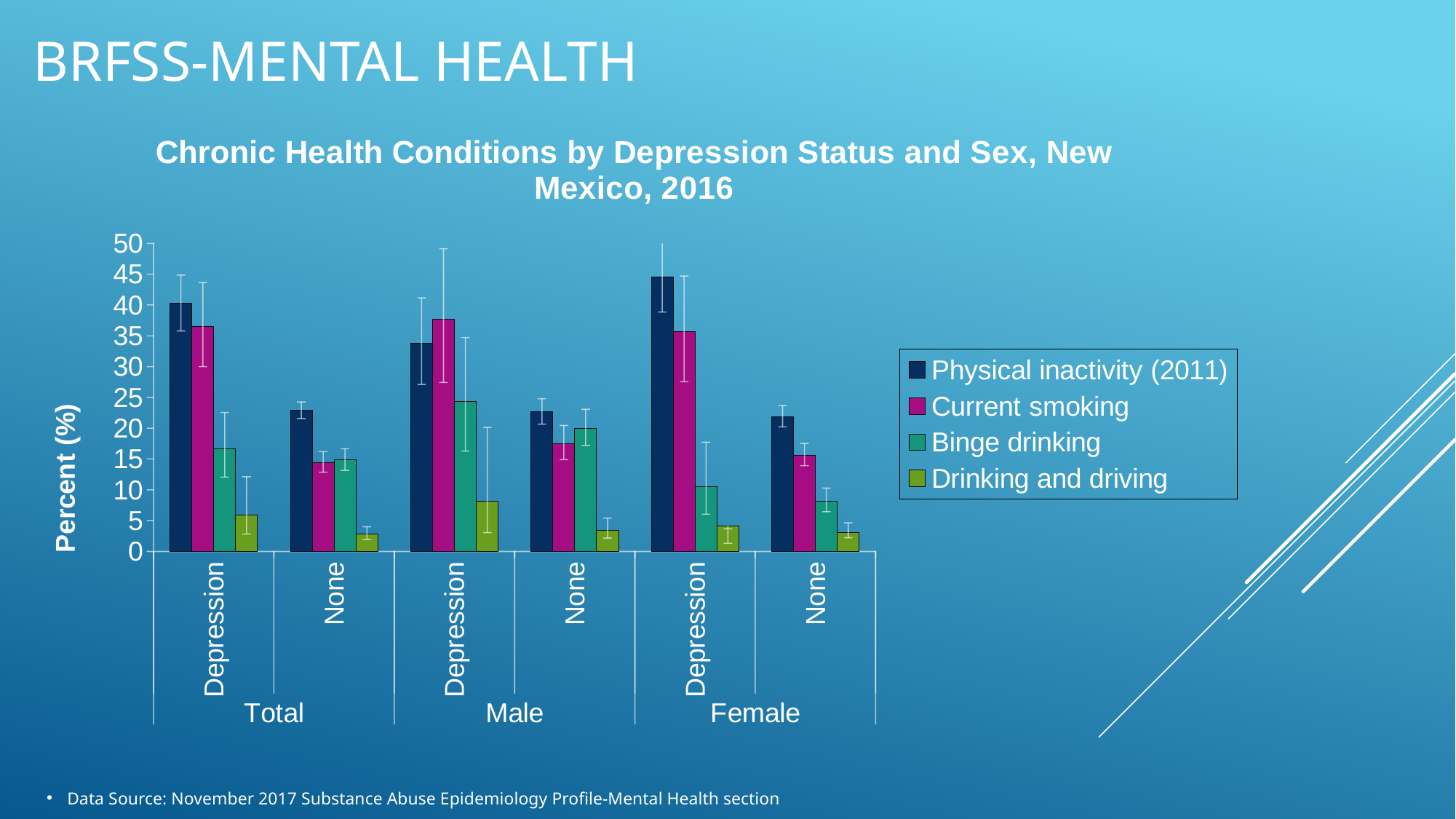
Which series has the lowest value in the Total Depression group? Drinking and driving Is the value for Current smoking in the Total Depression group greater or less than 30? greater How many groups of bars (depression-status categories) are shown along the x axis? 6 Which is larger: Binge drinking in the Male None group or Binge drinking in the Female None group? Male None What kind of chart is shown on the slide? Bar chart Is the value for Drinking and driving in the Total None group greater or less than 5? less How many series does the legend list? 4 In the Female Depression group, which is larger: Physical inactivity (2011) or Current smoking? Physical inactivity (2011) Is the value for Physical inactivity (2011) in the Female Depression group greater or less than 40? greater Which series has the highest value in the Female Depression group? Physical inactivity (2011) What is the label on the y axis of the chart? Percent (%)